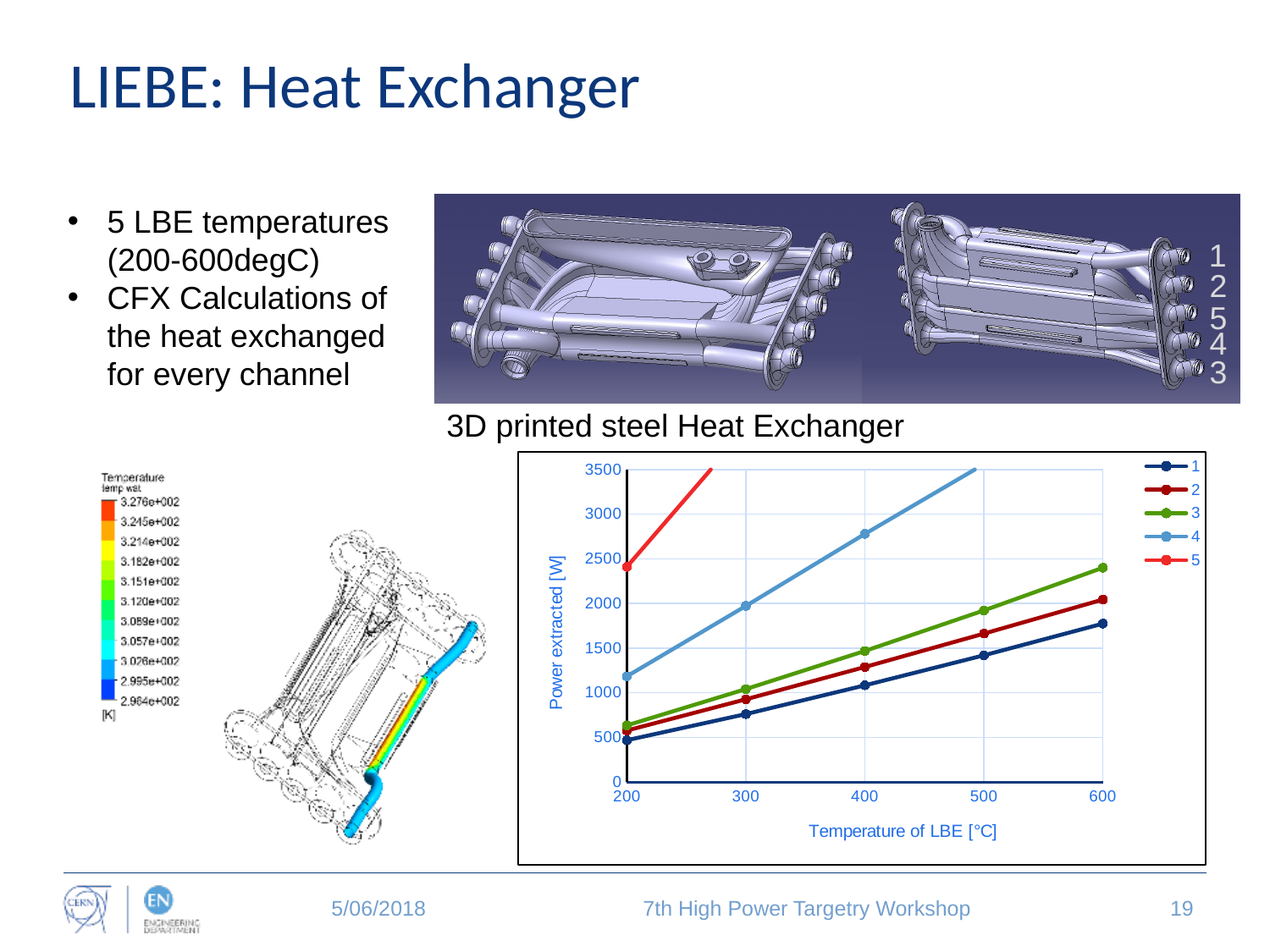
What is the label of the x axis of the chart? Temperature of LBE [°C] Which series has the highest power extracted at a temperature of 200 °C? 5 Is the power extracted for series 2 at 300 °C greater or less than 1000? less Is the power extracted for series 1 at 600 °C greater or less than 1500? greater How many series does the legend of the chart list? 5 Does the power extracted for series 1 rise or fall as the temperature of LBE increases? rise At 400 °C, which series has the larger power extracted, series 4 or series 1? 4 Which series has the lowest power extracted at a temperature of 600 °C? 1 What is the label of the y axis of the chart? Power extracted [W] Is the power extracted for series 4 at 400 °C greater or less than 2500? greater At 600 °C, which series has the larger power extracted, series 3 or series 2? 3 What kind of chart is shown on the slide? line chart